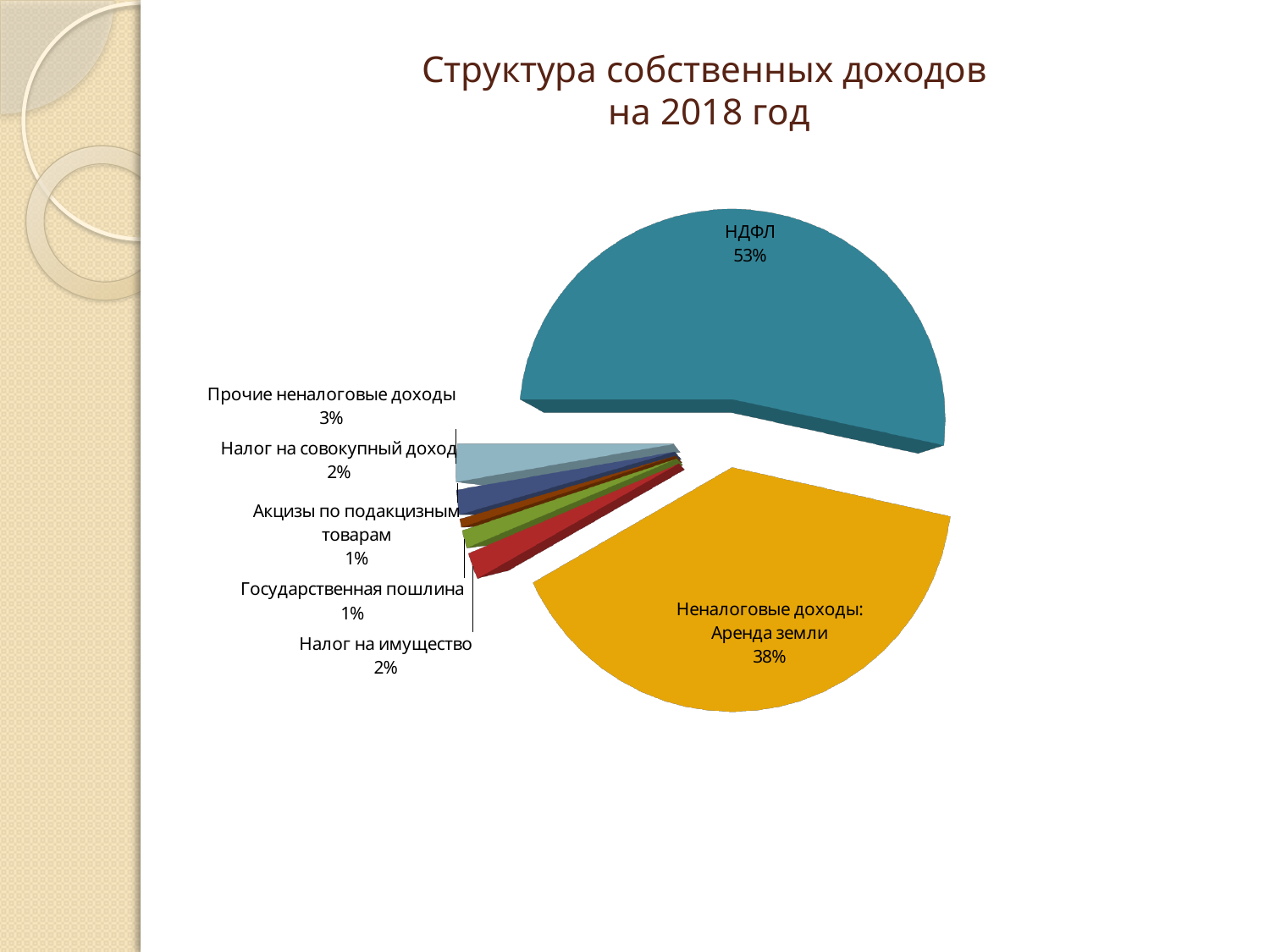
What share of the pie does Прочие неналоговые доходы have? 3% What is the difference in percentage points between НДФЛ and Неналоговые доходы: Аренда земли? 15 What share of the pie does Налог на совокупный доход have? 2% What is the title of the chart? Структура собственных доходов на 2018 год What share of the pie does Неналоговые доходы: Аренда земли have? 38% Which category has the largest slice of the pie? НДФЛ What share of the pie does Акцизы по подакцизным товарам have? 1% What share of the pie does НДФЛ have? 53% What kind of chart is shown on the slide? pie chart What share of the pie does Налог на имущество have? 2% How many slices does the pie chart have? 7 Which is larger, Прочие неналоговые доходы or Государственная пошлина? Прочие неналоговые доходы